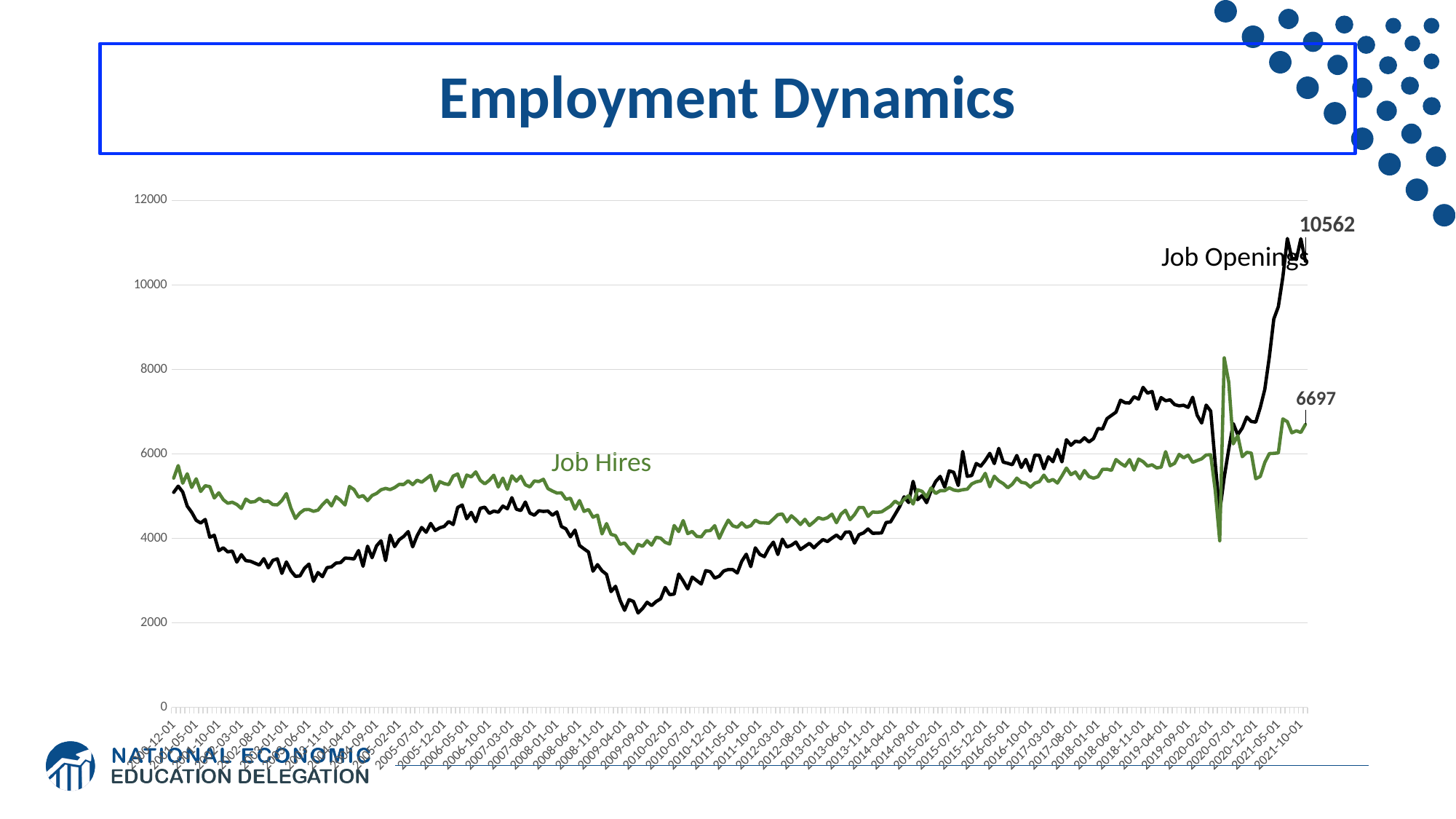
What is the difference between the final labelled values of Job Openings and Job Hires? 3865 What is the title of the chart? Employment Dynamics Does the Job Openings series rise or fall between 2008-01-01 and 2009-09-01? fall What colour is the Job Hires line? green Is the value of Job Openings at 2009-09-01 greater or less than 4000? less At the end of the series, which is larger: Job Openings or Job Hires? Job Openings Is the value of Job Openings at 2018-11-01 greater or less than 6000? greater Is the value of Job Hires at 2005-12-01 greater or less than 4000? greater What is the final labelled value of the Job Openings series? 10562 What is the final labelled value of the Job Hires series? 6697 How many data series are plotted on the chart? 2 What kind of chart is shown on the slide? line chart